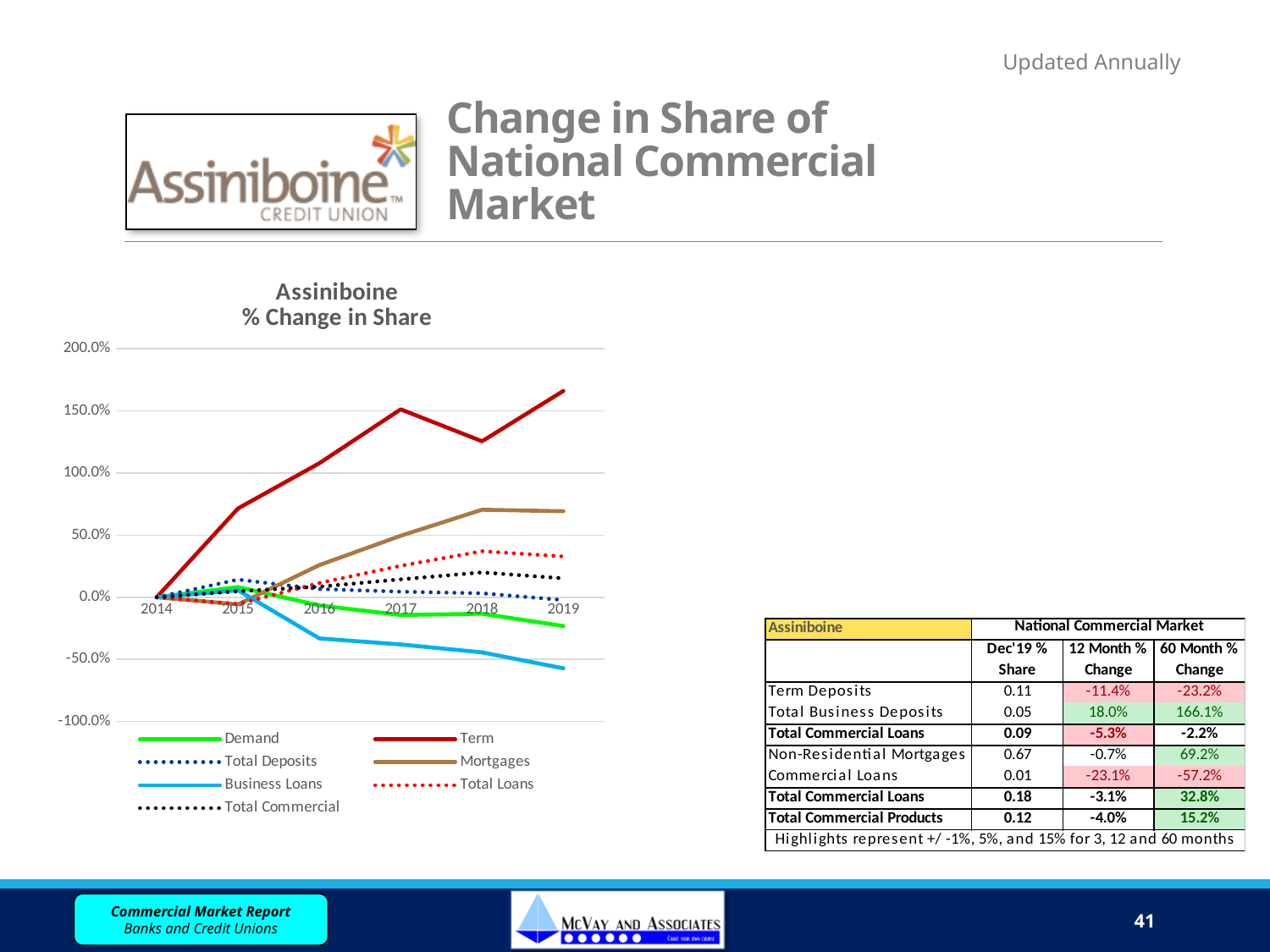
Does the Business Loans series generally rise or fall from 2014 to 2019? fall Does the Term series generally rise or fall from 2014 to 2019? rise Is the value for Business Loans in 2019 greater or less than -50.0%? less Is the value for Mortgages in 2019 greater or less than 50.0%? greater Is the value for Term in 2019 greater or less than 150.0%? greater Which series has the lowest value in 2019? Business Loans What kind of chart is shown on the slide? line chart How many years are shown along the x axis of the chart? 6 How many series does the legend of the chart list? 7 In 2017, which is larger: the value for Term or the value for Mortgages? Term Which series has the highest value in 2019? Term What is the title of the chart? Assiniboine % Change in Share